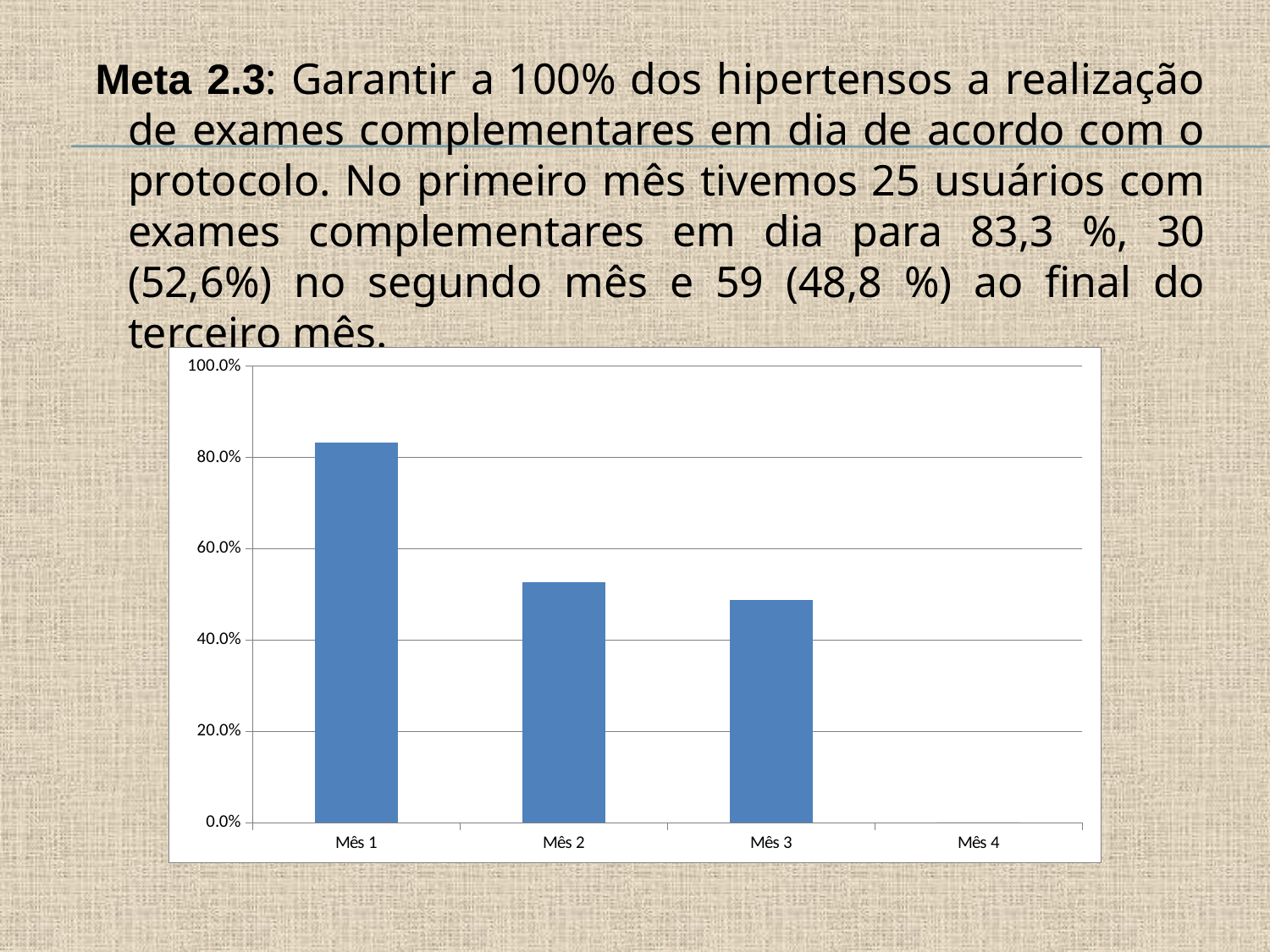
Among the months with a plotted bar, which has the lowest value? Mês 3 Is the value for Mês 1 greater or less than 80.0%? greater Which month has the highest bar in the chart? Mês 1 Is the value for Mês 2 greater or less than 60.0%? less What kind of chart is shown on the slide? bar chart Is the value for Mês 2 greater or less than 40.0%? greater How many bars are plotted in the chart? 3 How many categories are labelled on the x axis of the chart? 4 Which is larger, the value for Mês 1 or the value for Mês 2? Mês 1 Do the bar values rise or fall from Mês 1 to Mês 3? fall Which x-axis category has no bar plotted? Mês 4